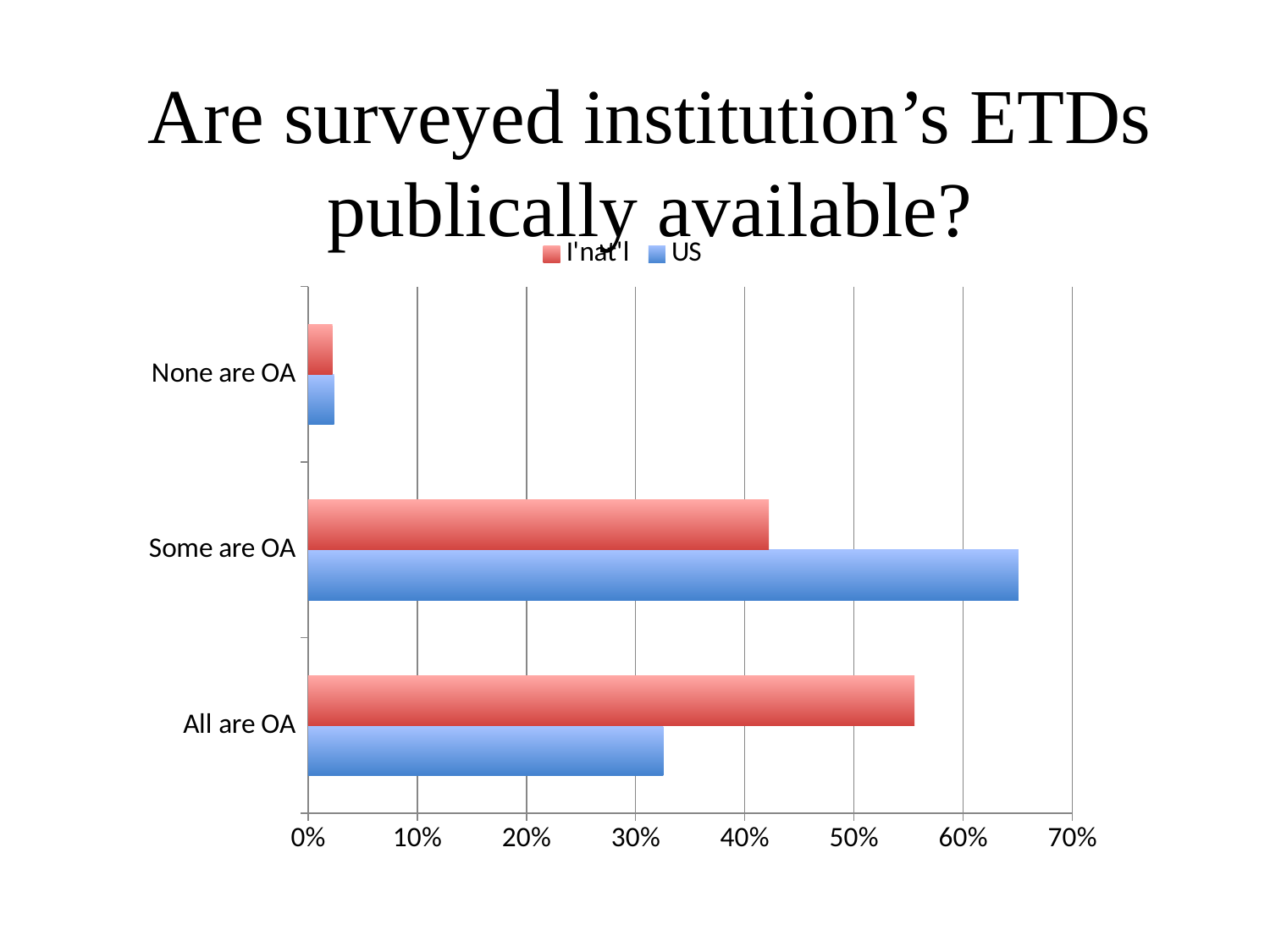
How many categories are shown on the chart? 3 What kind of chart is shown on the slide? bar chart Which series is shown in blue? US How many series does the legend list? 2 Is the US value for Some are OA greater or less than 60%? greater Is the I'nat'l value for Some are OA greater or less than 50%? less Is the US value for All are OA greater or less than 40%? less Which category has the lowest US value? None are OA For All are OA, which series has the larger value, I'nat'l or US? I'nat'l For Some are OA, which series has the larger value, I'nat'l or US? US